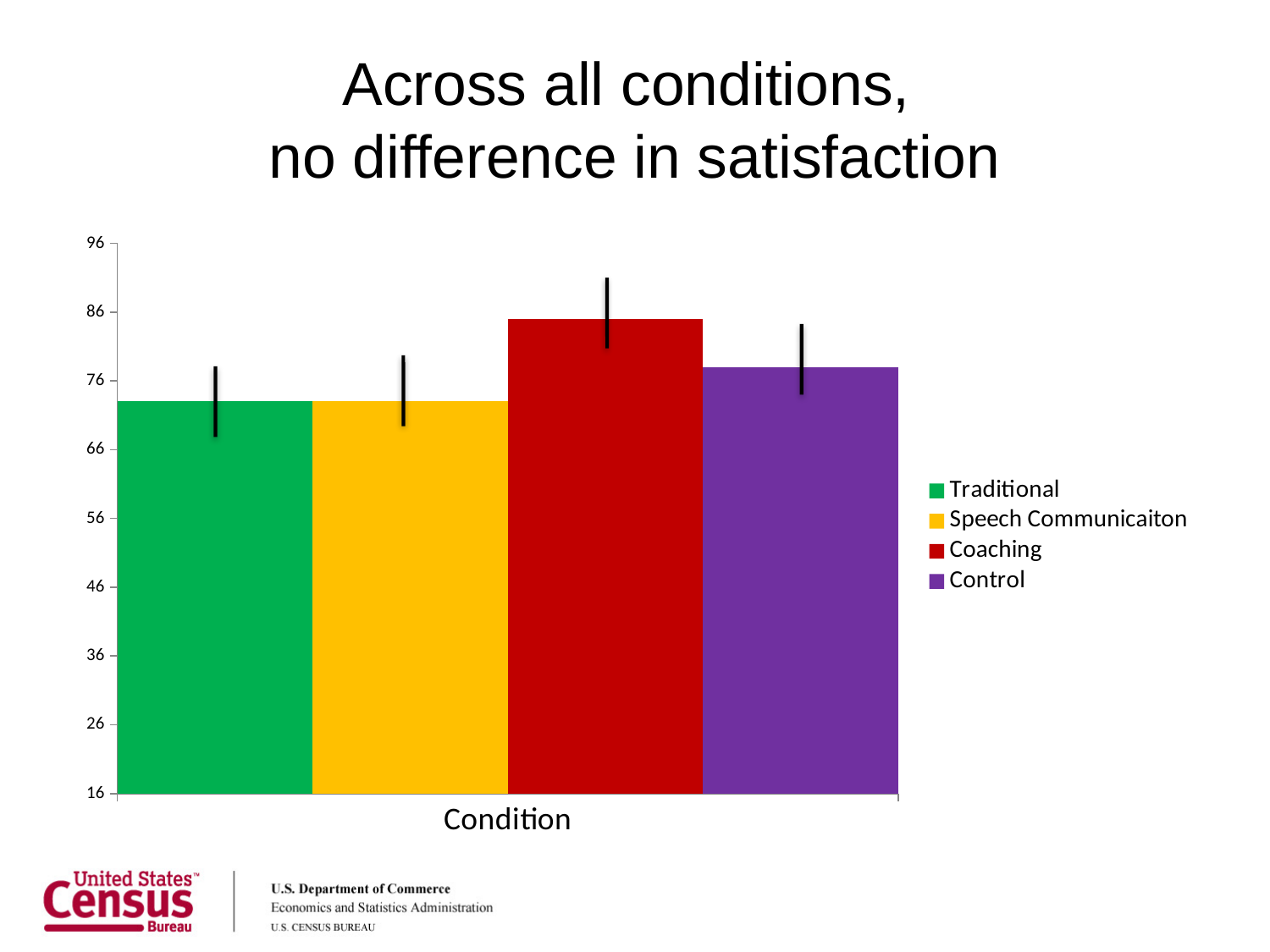
Is the value for Control greater or less than 86? less Which is larger, the value for Control or the value for Traditional? Control What colour is the bar for Coaching? red How many bars are plotted in the chart? 4 Is the value for Speech Communicaiton greater or less than 66? greater Which condition has the highest satisfaction value? Coaching How many entries does the legend list? 4 What is the label on the x axis of the chart? Condition What kind of chart is shown on the slide? bar chart Is the value for Traditional greater or less than 76? less Which is larger, the value for Coaching or the value for Control? Coaching